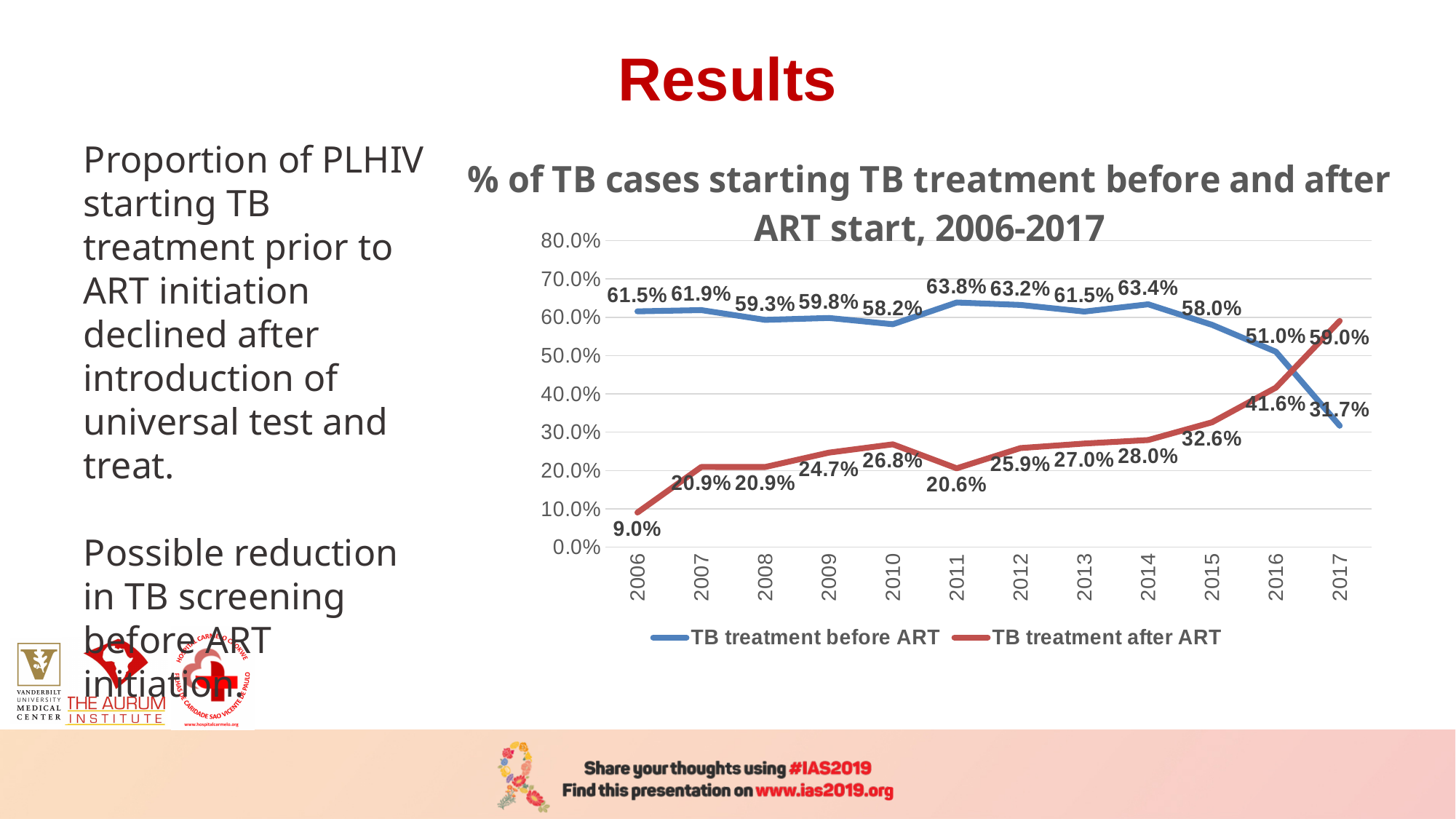
Does the TB treatment after ART series generally rise or fall from 2014 to 2017? Rise What is the value for TB treatment after ART in 2017? 59.0% In 2017, which series has the larger value, TB treatment before ART or TB treatment after ART? TB treatment after ART What is the value for TB treatment before ART in 2011? 63.8% What is the title of the chart? % of TB cases starting TB treatment before and after ART start, 2006-2017 How many years are plotted along the x axis? 12 In which year is the TB treatment after ART value highest? 2017 In which year is the TB treatment before ART value lowest? 2017 How many series does the legend list? 2 What type of chart is shown on the slide? Line chart What is the value for TB treatment after ART in 2006? 9.0% What is the difference between TB treatment before ART and TB treatment after ART in 2006? 52.5%